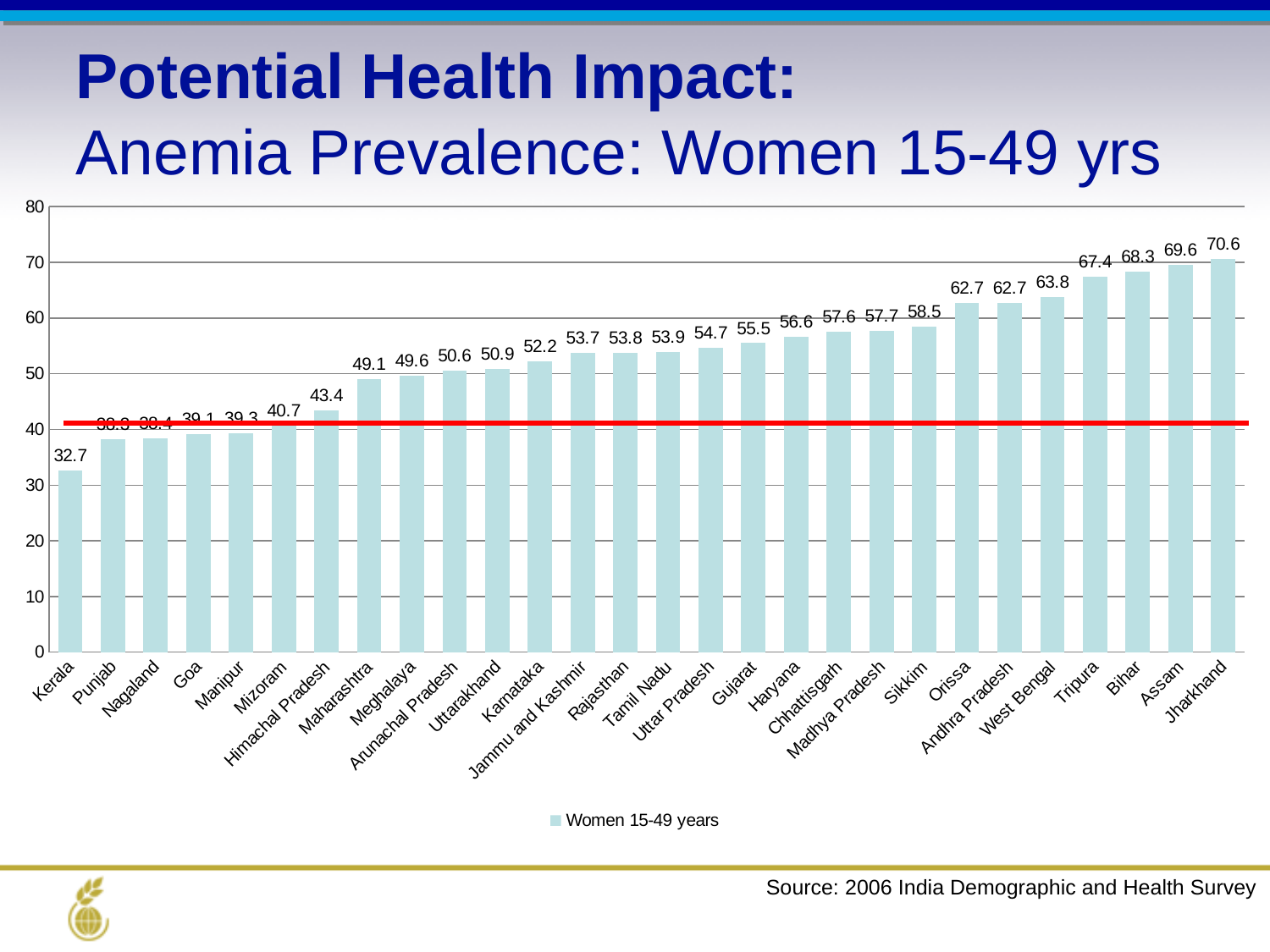
What type of chart is shown on the slide? bar chart What is the value shown for Jharkhand? 70.6 How many states are shown in the chart? 28 Which state has the lowest anemia prevalence in the chart? Kerala What series name does the legend show? Women 15-49 years What is the anemia prevalence value for Kerala? 32.7 What is the difference between the values for Jharkhand and Kerala? 37.9 Which has a higher value, Bihar or Tripura? Bihar Is the value for Himachal Pradesh greater or less than 50? less What is the value shown for Karnataka? 52.2 Which state has the highest anemia prevalence in the chart? Jharkhand What is the value shown for Sikkim? 58.5